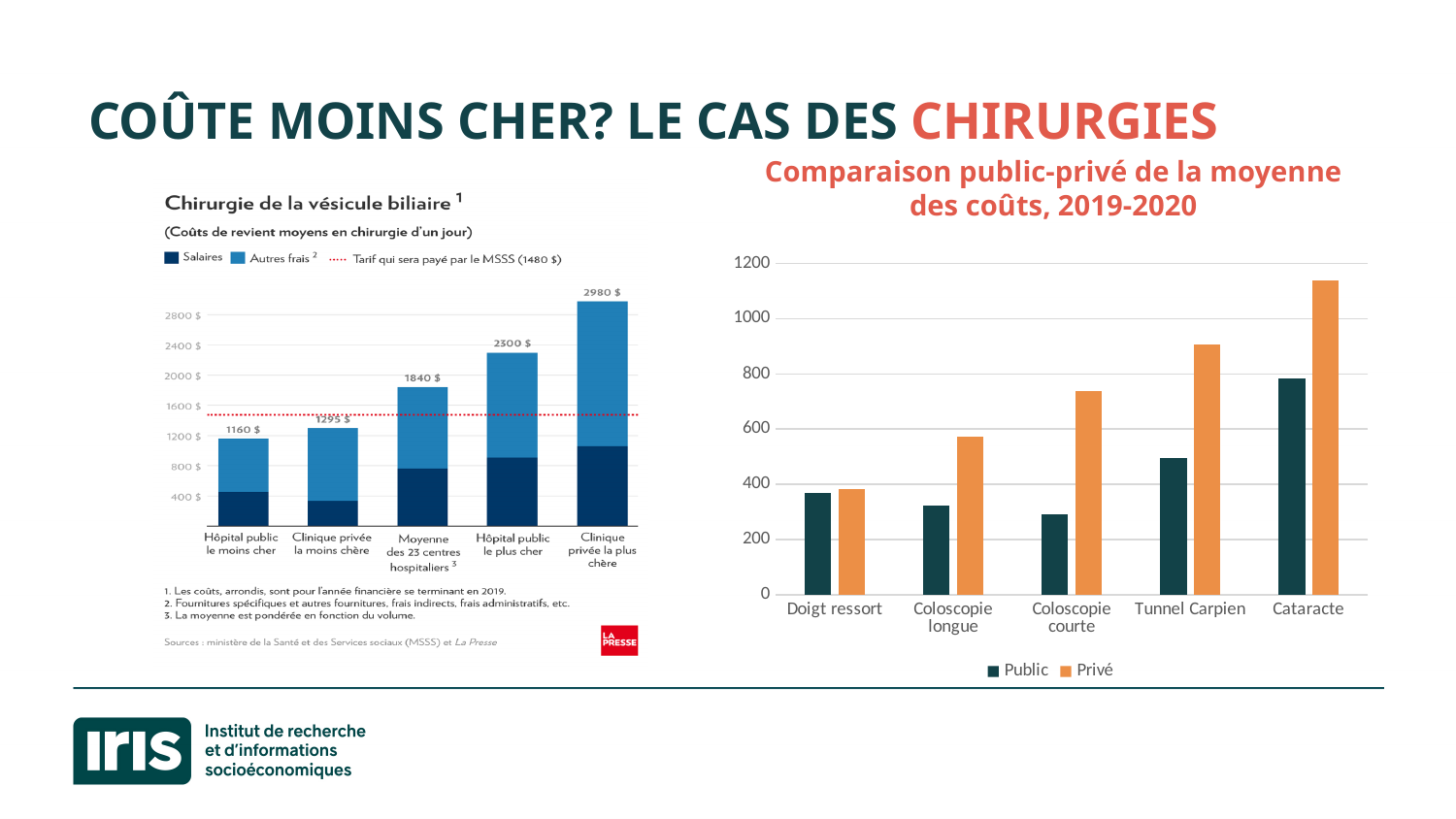
In the chart titled 'Chirurgie de la vésicule biliaire', what is the total cost shown for 'Clinique privée la plus chère'? 2980 $ In the chart titled 'Chirurgie de la vésicule biliaire', what is the difference between the totals for 'Hôpital public le plus cher' and 'Clinique privée la moins chère'? 1005 $ In the chart titled 'Chirurgie de la vésicule biliaire', what is the value labelled for 'Moyenne des 23 centres hospitaliers'? 1840 $ In the chart titled 'Comparaison public-privé de la moyenne des coûts, 2019-2020', is the Public value for Coloscopie courte greater or less than 400? less In the chart titled 'Comparaison public-privé de la moyenne des coûts, 2019-2020', is the Privé value for Cataracte greater or less than 1000? greater In the chart titled 'Chirurgie de la vésicule biliaire', how many categories are shown on the x axis? 5 In the chart titled 'Chirurgie de la vésicule biliaire', what is the total cost shown for 'Hôpital public le moins cher'? 1160 $ In the chart titled 'Comparaison public-privé de la moyenne des coûts, 2019-2020', which is larger for Tunnel Carpien, the Public or the Privé value? Privé In the chart titled 'Comparaison public-privé de la moyenne des coûts, 2019-2020', which category has the highest Privé value? Cataracte In the chart titled 'Chirurgie de la vésicule biliaire', which category has the lowest total cost? Hôpital public le moins cher In the chart titled 'Comparaison public-privé de la moyenne des coûts, 2019-2020', how many series does the legend list? 2 In the chart titled 'Chirurgie de la vésicule biliaire', what tariff does the dotted line represent according to the legend? Tarif qui sera payé par le MSSS (1480 $)